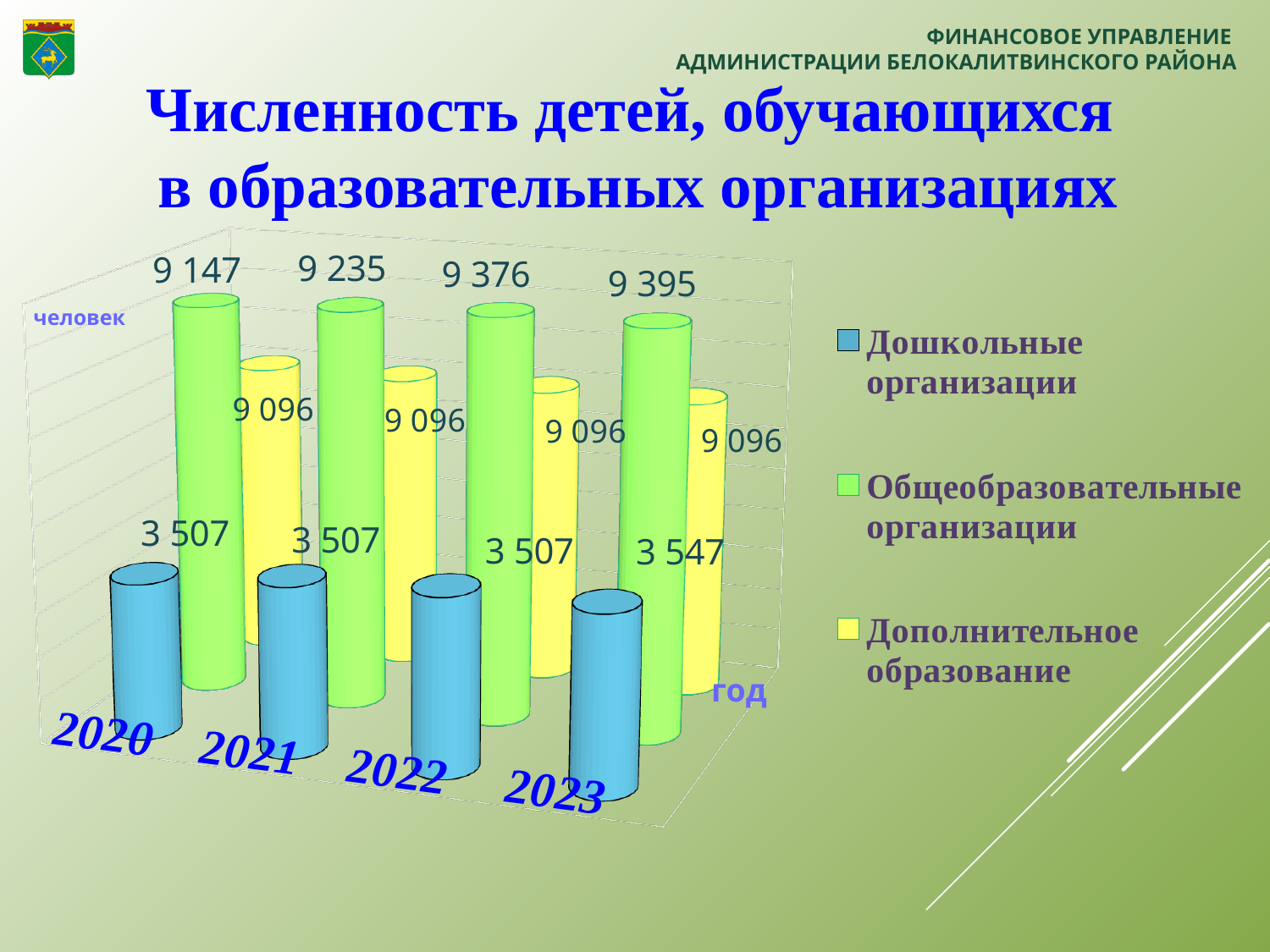
What is the value for Общеобразовательные организации in 2023? 9 395 Do the values for Общеобразовательные организации rise or fall from 2020 to 2023? rise How many series does the legend list? 3 What is the value for Дополнительное образование in 2022? 9 096 In which year is the value for Общеобразовательные организации lowest? 2020 What is the difference between the Общеобразовательные организации values for 2023 and 2020? 248 What kind of chart is shown on the slide? bar chart Which is larger in 2021: Общеобразовательные организации or Дополнительное образование? Общеобразовательные организации How many years are shown on the x axis? 4 What is the difference between the Дошкольные организации values for 2023 and 2022? 40 What is the value for Дошкольные организации in 2020? 3 507 In which year is the value for Общеобразовательные организации highest? 2023